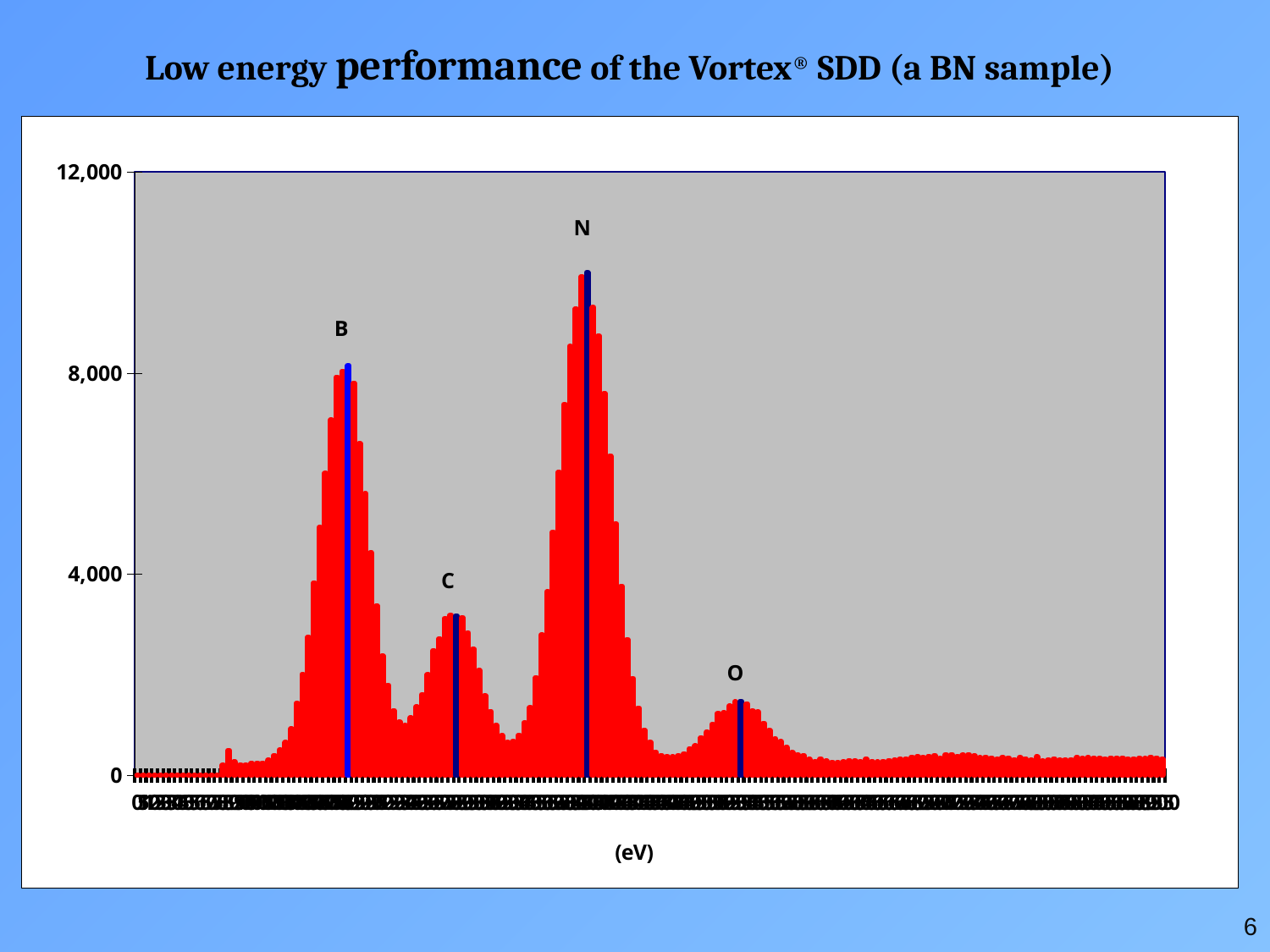
Is the height of the C peak greater or less than 4,000? less Which peak is taller, B or C? B Is the height of the O peak greater or less than 4,000? less Which peak is taller, C or O? C Is the height of the B peak greater or less than 4,000? greater What is the x-axis title of the chart? (eV) How many labeled peaks are marked on the chart? 4 Which peak is taller, N or B? N What is the highest value shown on the y-axis of the chart? 12,000 Which labeled peak is the lowest on the chart? O Which labeled peak is the highest on the chart? N